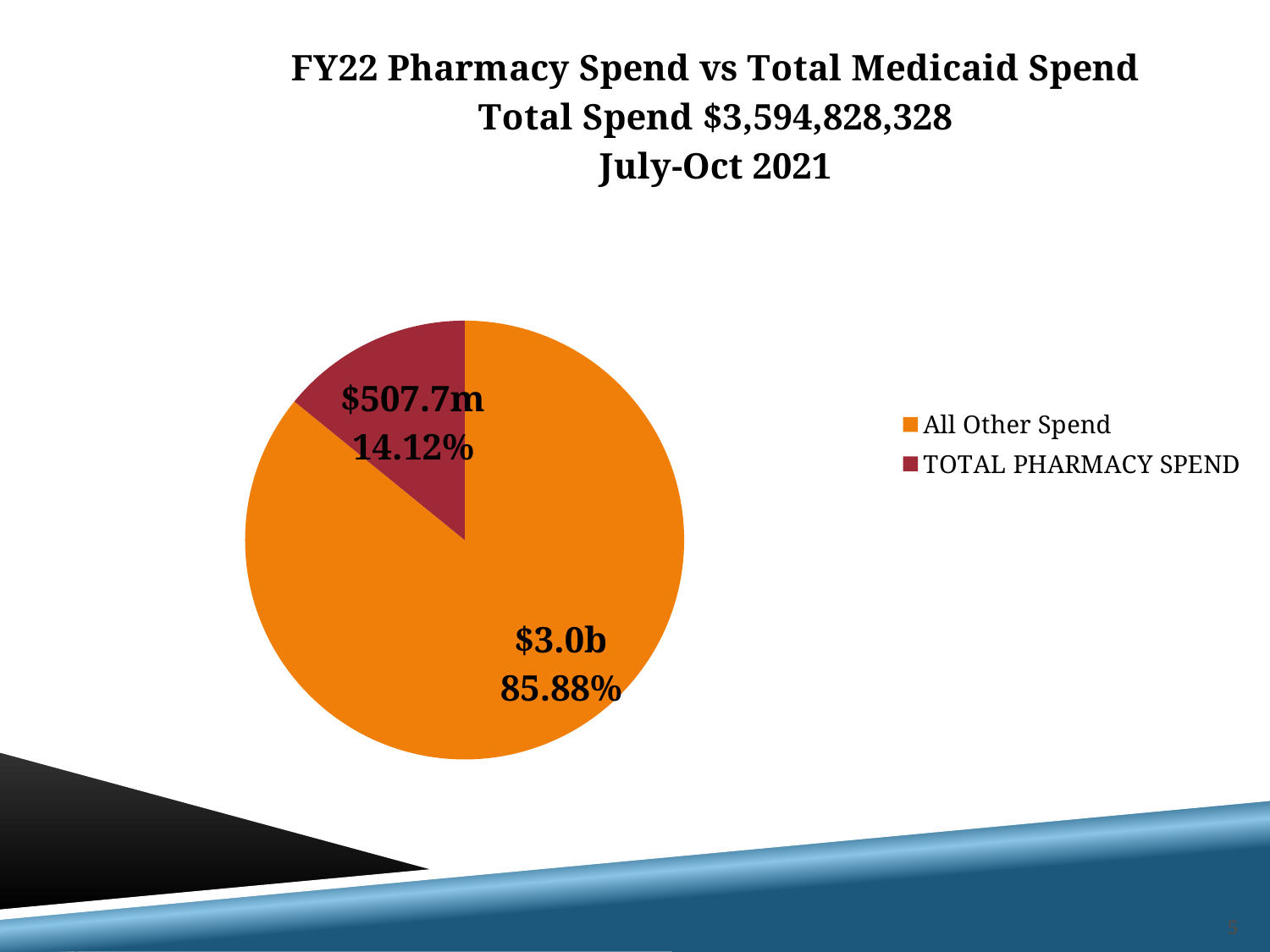
What is the value shown for TOTAL PHARMACY SPEND? $507.7m What percentage share of the pie is TOTAL PHARMACY SPEND? 14.12% How many slices does the pie chart have? 2 How many entries does the legend list? 2 What is the value shown for All Other Spend? $3.0b What colour is the TOTAL PHARMACY SPEND slice? dark red What kind of chart is shown on the slide? pie chart Which is larger, All Other Spend or TOTAL PHARMACY SPEND? All Other Spend What is the total spend stated in the chart title? $3,594,828,328 Which slice is the largest? All Other Spend What percentage share of the pie is All Other Spend? 85.88% Which slice is the smallest? TOTAL PHARMACY SPEND